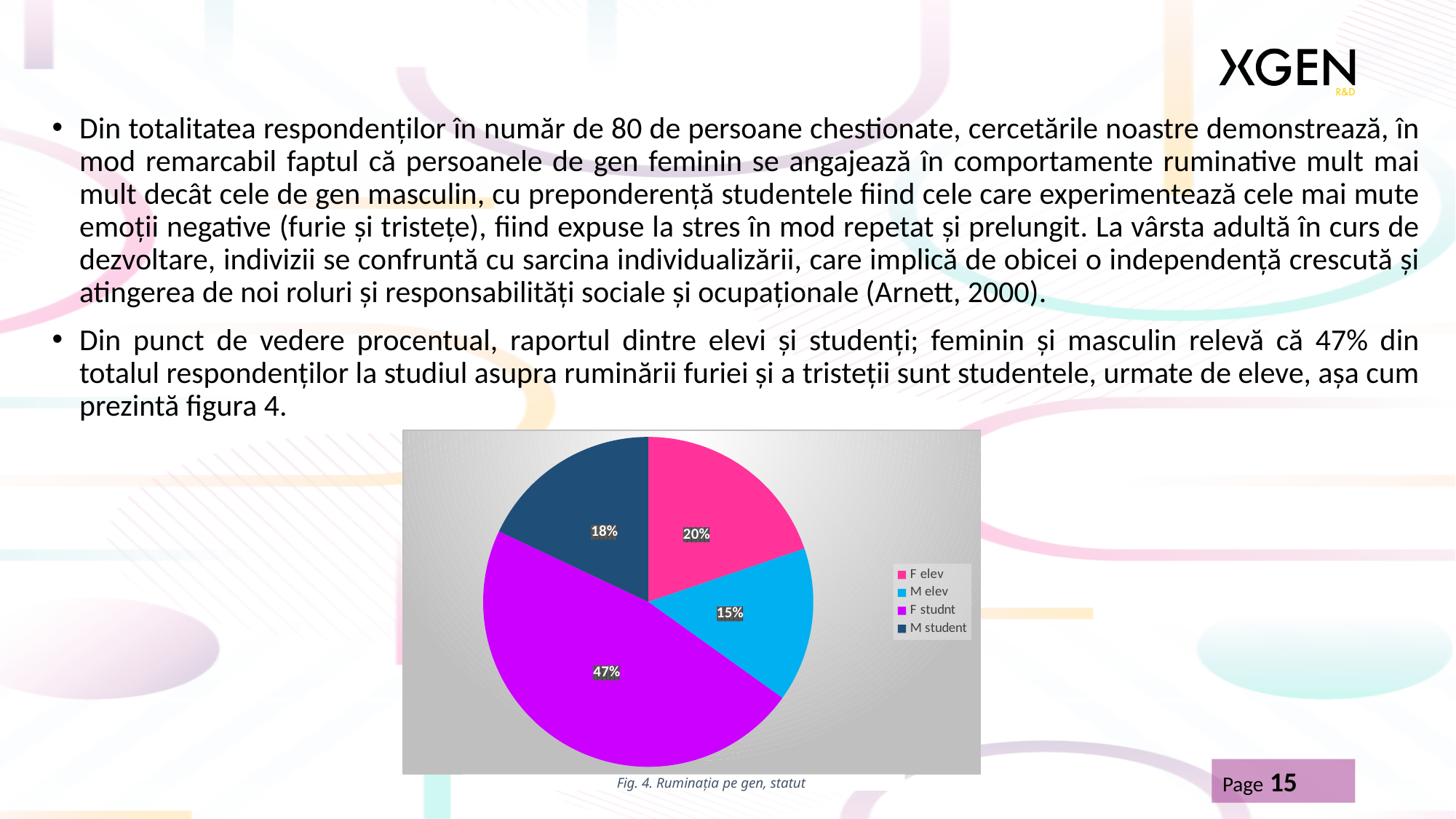
Which category has the largest slice of the pie? F studnt Which slice is larger, F elev or M student? F elev How many slices does the pie chart have? 4 What kind of chart is shown on the slide? pie chart What percentage does the M student slice show? 18% How many entries does the legend list? 4 Which category has the smallest slice of the pie? M elev What percentage does the M elev slice show? 15% What percentage does the F studnt slice show? 47% What is the difference in percentage points between the F studnt slice and the F elev slice? 27 What percentage does the F elev slice show? 20% What is the caption of the figure below the chart? Fig. 4. Ruminația pe gen, statut